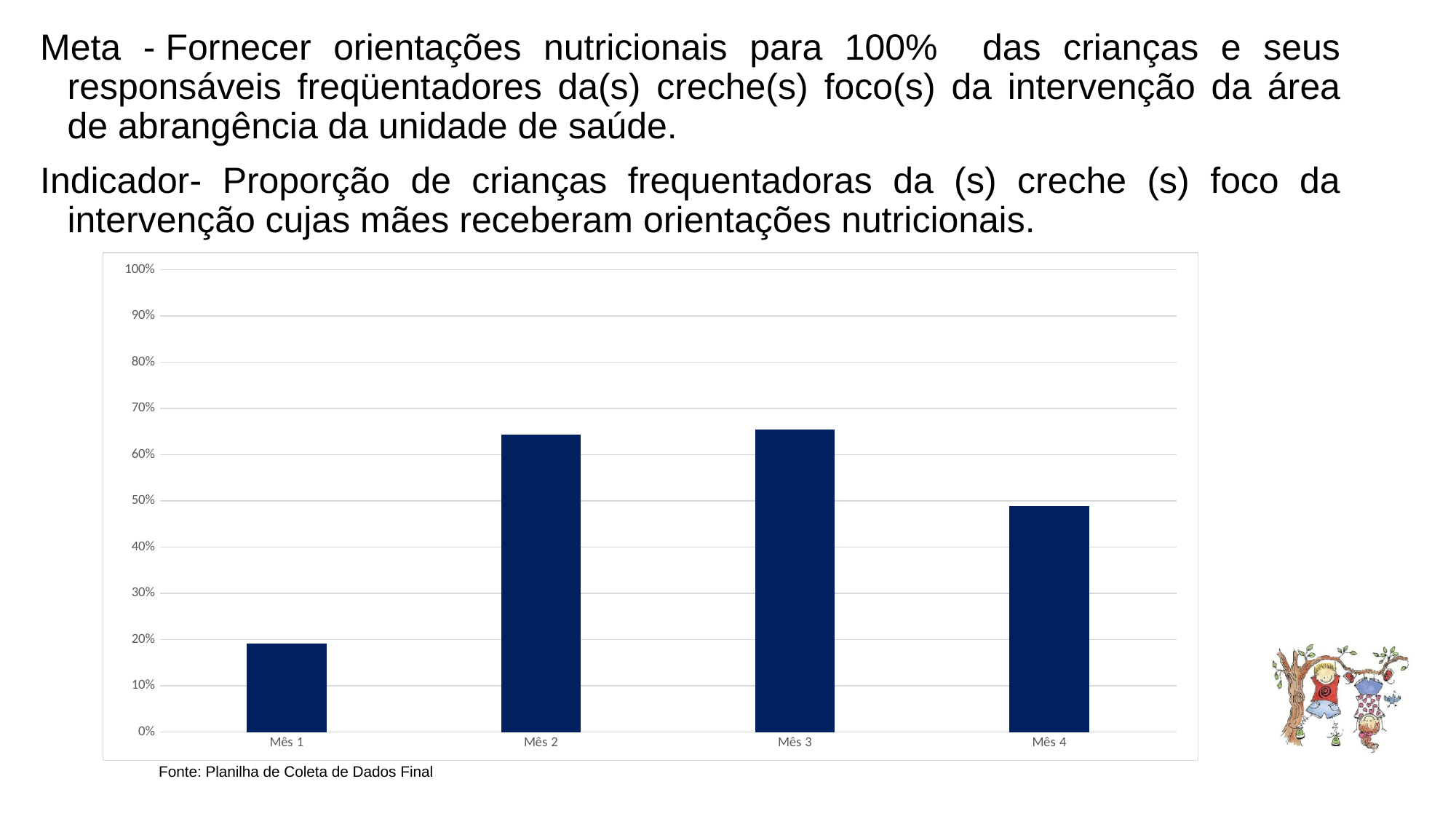
Which is larger, the value for Mês 2 or the value for Mês 4? Mês 2 What kind of chart is shown on the slide? bar chart Is the value for Mês 4 greater or less than 40%? greater Does the value rise or fall from Mês 1 to Mês 2? rise Is the value for Mês 1 greater or less than 20%? less How many categories (months) are shown on the x axis of the chart? 4 Is the value for Mês 3 greater or less than 70%? less Which month has the lowest value in the chart? Mês 1 What source is cited below the chart? Fonte: Planilha de Coleta de Dados Final Does the value rise or fall from Mês 3 to Mês 4? fall Which is larger, the value for Mês 1 or the value for Mês 4? Mês 4